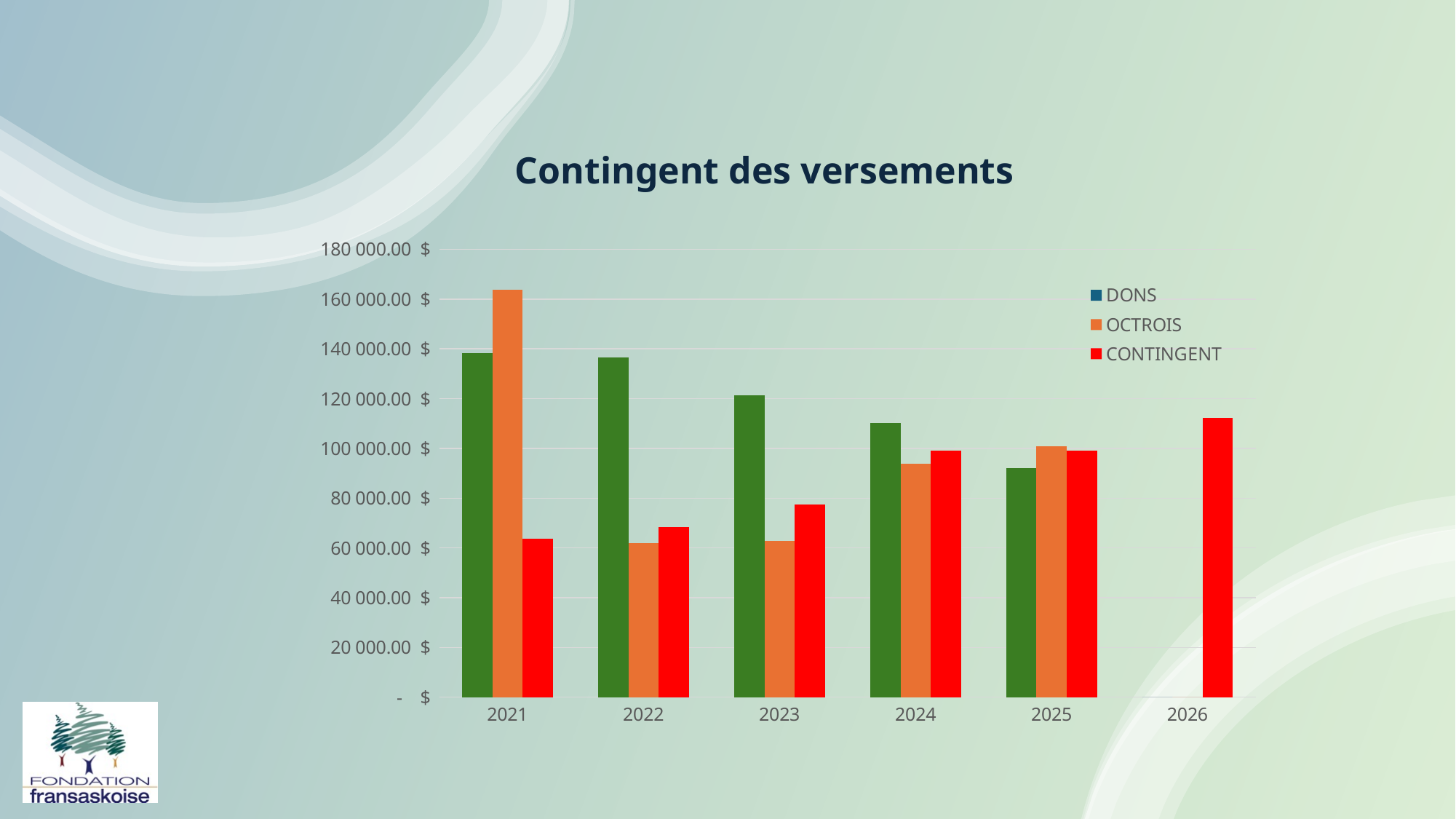
Is the CONTINGENT value for 2021 greater or less than 80 000.00 $? less In which year is the DONS value lowest? 2025 In 2021, which is larger: DONS or OCTROIS? OCTROIS In which year is the CONTINGENT value highest? 2026 In which year is the OCTROIS value highest? 2021 What is the title of the chart? Contingent des versements Is the OCTROIS value for 2021 greater or less than 160 000.00 $? greater Do the DONS values rise or fall from 2021 to 2025? fall How many years are shown on the x axis? 6 Do the CONTINGENT values rise or fall from 2021 to 2026? rise What kind of chart is shown on the slide? Bar chart How many series does the legend list? 3